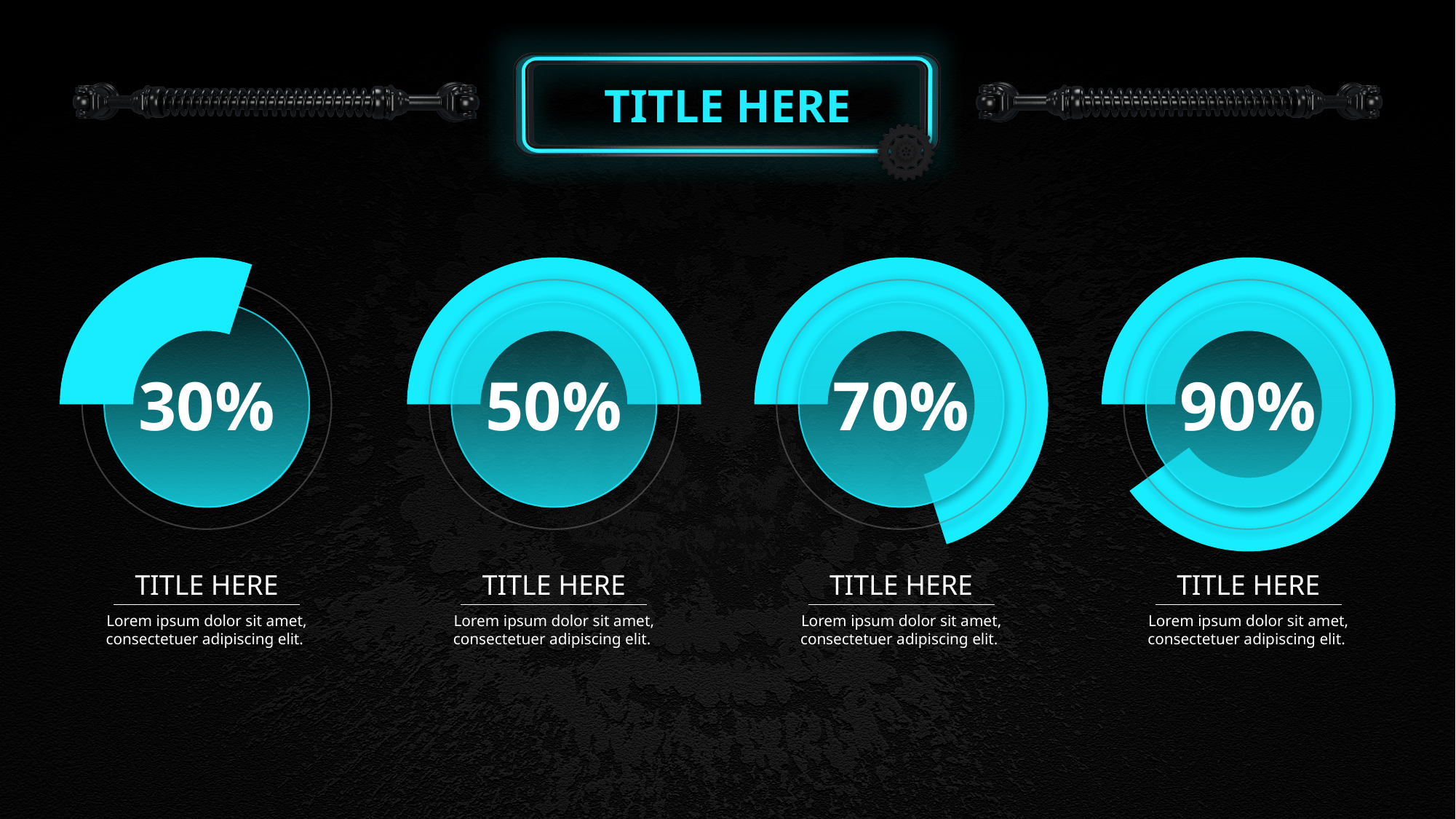
What colour is used for the filled progress ring in each chart? Cyan What value is shown in the second circular chart from the left? 50% How many circular progress charts are on the slide? 4 Which is larger, the value in the second chart or the value in the third chart? The third chart (70%) What value is shown in the third circular chart from the left? 70% What value is shown in the rightmost circular chart? 90% What value is shown in the leftmost circular chart? 30% Do the percentage values increase or decrease from left to right across the slide? Increase What is the difference between the value in the rightmost chart and the value in the leftmost chart? 60% Which circular chart shows the highest percentage? The rightmost chart (90%) Which circular chart shows the lowest percentage? The leftmost chart (30%) What is the difference between the third chart's value and the second chart's value? 20%